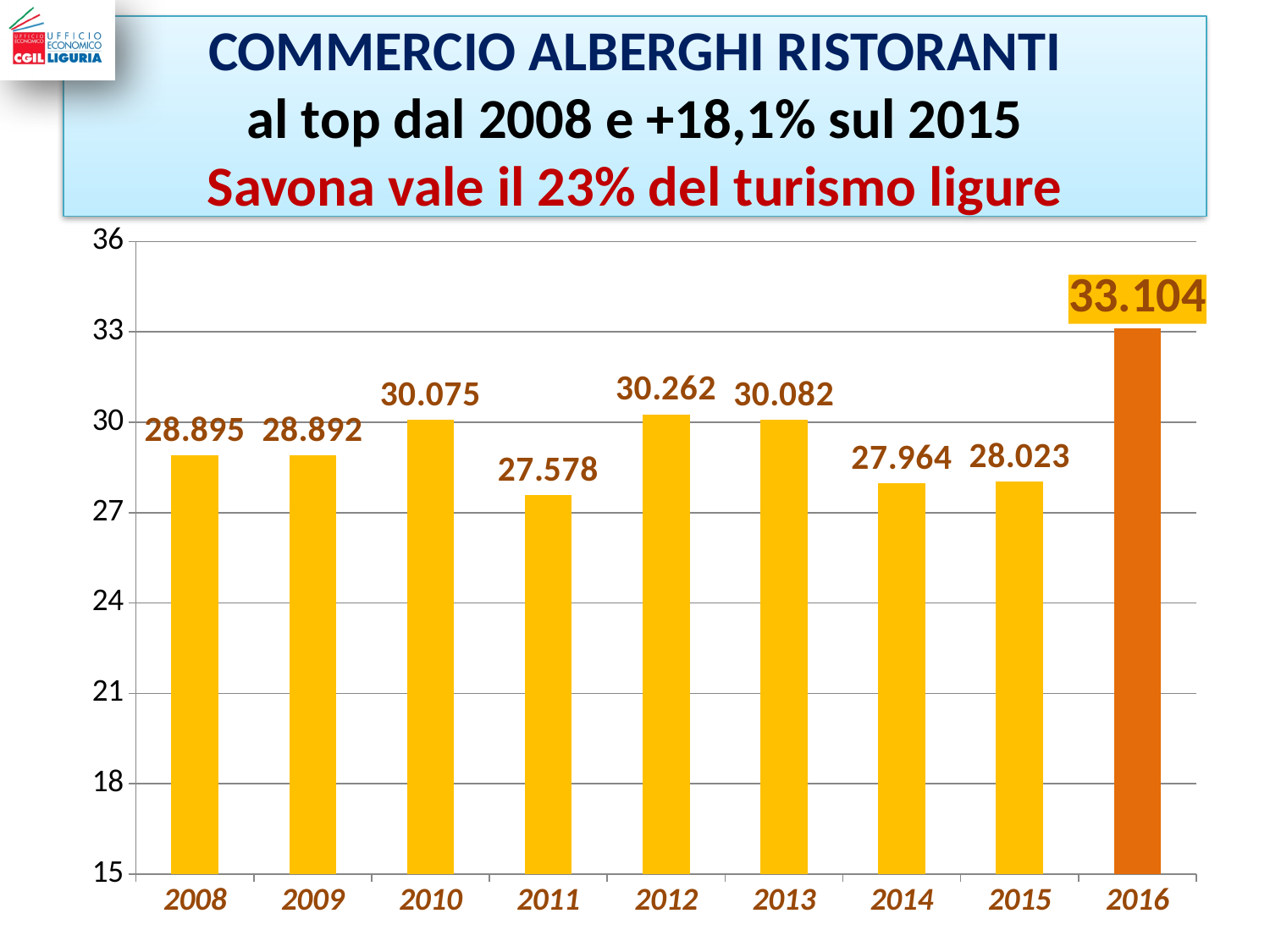
What is the difference between the values for 2016 and 2015? 5.081 What is the value for 2011? 27.578 Which is larger, the value for 2012 or the value for 2013? 2012 Which year has the lowest value? 2011 Which year's bar is shown in a different colour from the others? 2016 What is the value for 2013? 30.082 How many years are shown on the x axis? 9 Which year has the highest value? 2016 What kind of chart is shown on the slide? bar chart What is the value for 2016? 33.104 Is the value for 2014 greater or less than 30? less What is the difference between the values for 2010 and 2011? 2.497